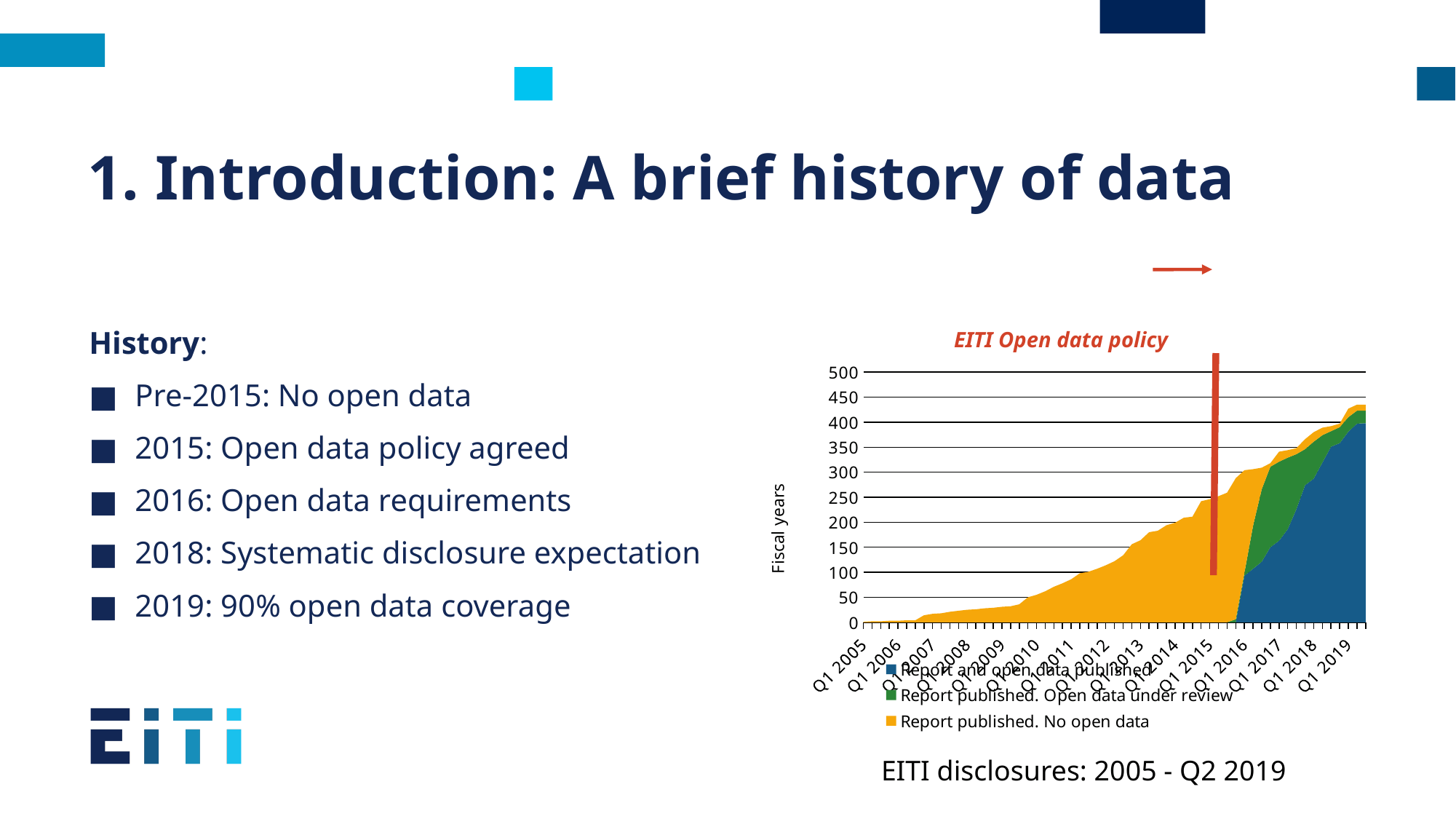
Which series accounts for the largest share of the total at Q1 2019? Report and open data published How many series does the chart's legend list? 3 How many year labels are shown along the x axis? 15 Is the total value at Q1 2017 greater or less than 300? greater Is the total value at Q1 2018 greater or less than 350? greater Is the total value at Q1 2019 greater or less than 400? greater What kind of chart is shown on the slide? Stacked area chart Does the total number of fiscal years disclosed rise or fall from Q1 2005 to Q1 2019? Rise What is the label on the chart's vertical axis? Fiscal years